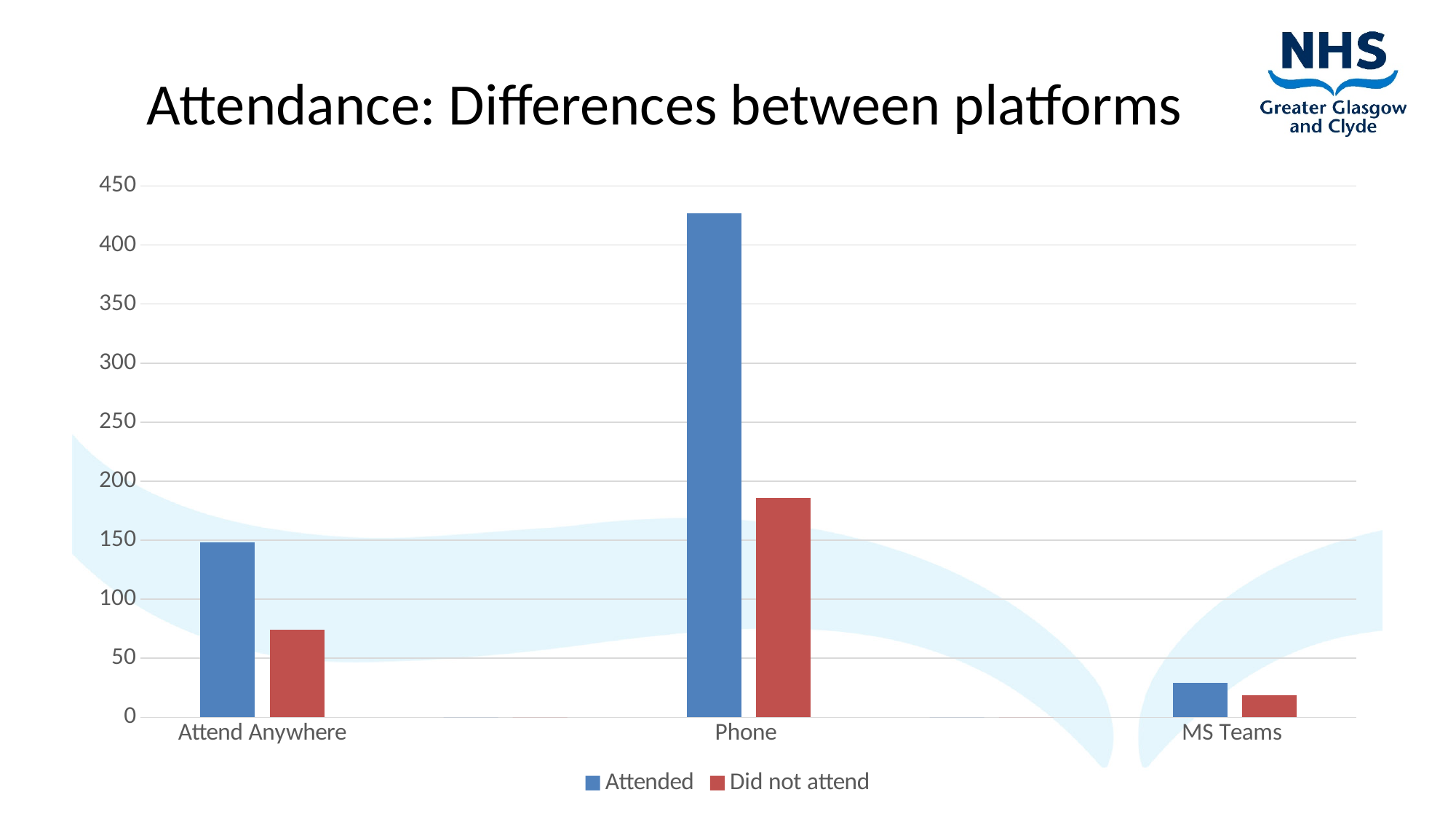
How many platform categories are shown on the x axis? 3 Which platform has the lowest Did not attend value? MS Teams Which platform has the highest Attended value? Phone Is the Attended value for MS Teams greater or less than 50? less How many series does the legend list? 2 Is the Did not attend value for Phone greater or less than 200? less What is the title of the chart? Attendance: Differences between platforms Is the Attended value for Phone greater or less than 400? greater Which platform has the lowest Attended value? MS Teams For Attend Anywhere, which is larger: Attended or Did not attend? Attended What kind of chart is shown on the slide? bar chart